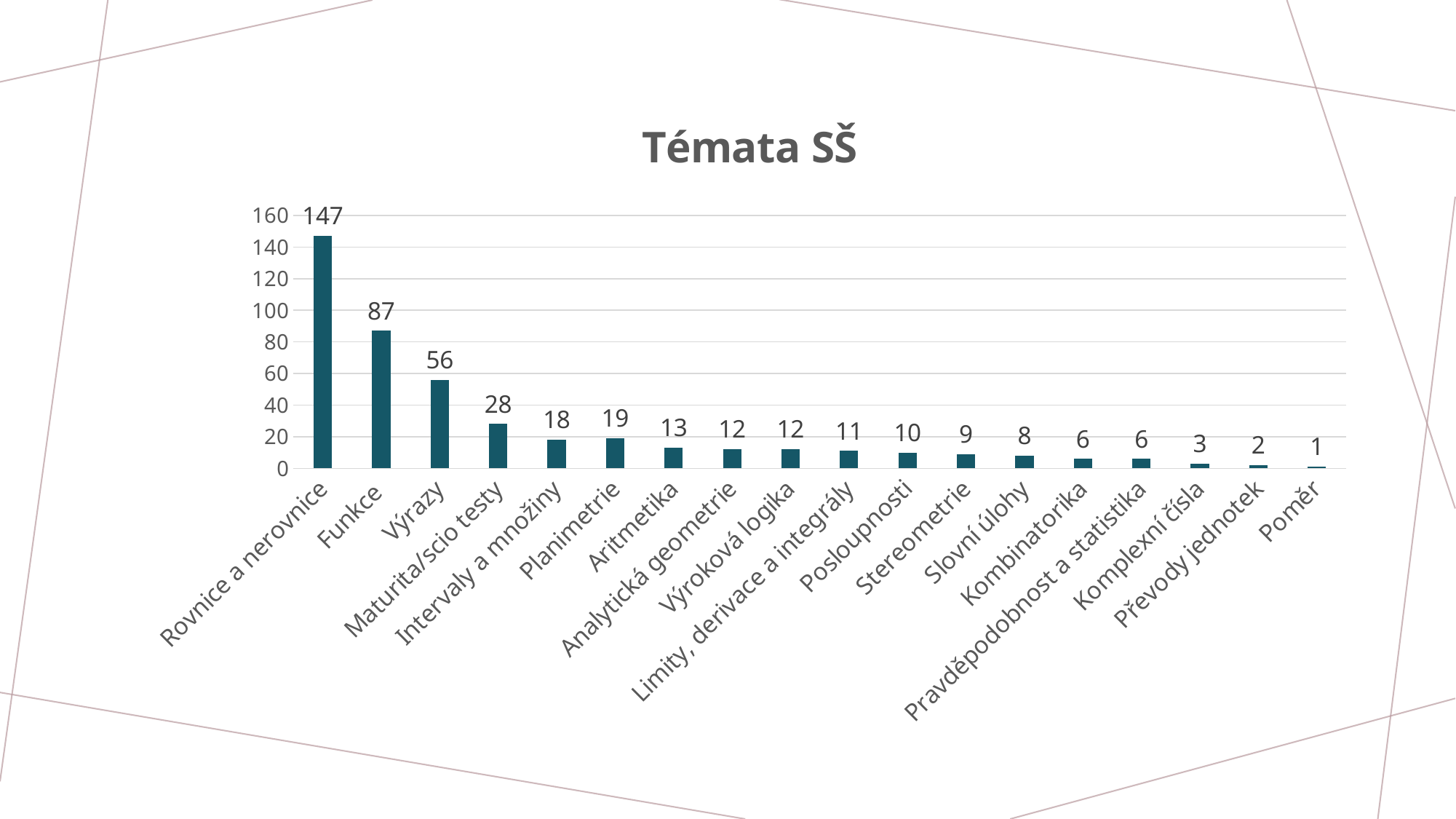
Which category has the lowest value? Poměr What is the title of the chart? Témata SŠ Which category has the highest value? Rovnice a nerovnice What is the value for Planimetrie? 19 What kind of chart is shown on the slide? bar chart How many categories are shown on the x axis? 18 What is the value for Kombinatorika? 6 What is the difference between the values for Rovnice a nerovnice and Funkce? 60 Which is larger, the value for Intervaly a množiny or the value for Planimetrie? Planimetrie Is the value for Výrazy greater or less than 40? greater What is the difference between the values for Výrazy and Maturita/scio testy? 28 What is the value for Funkce? 87